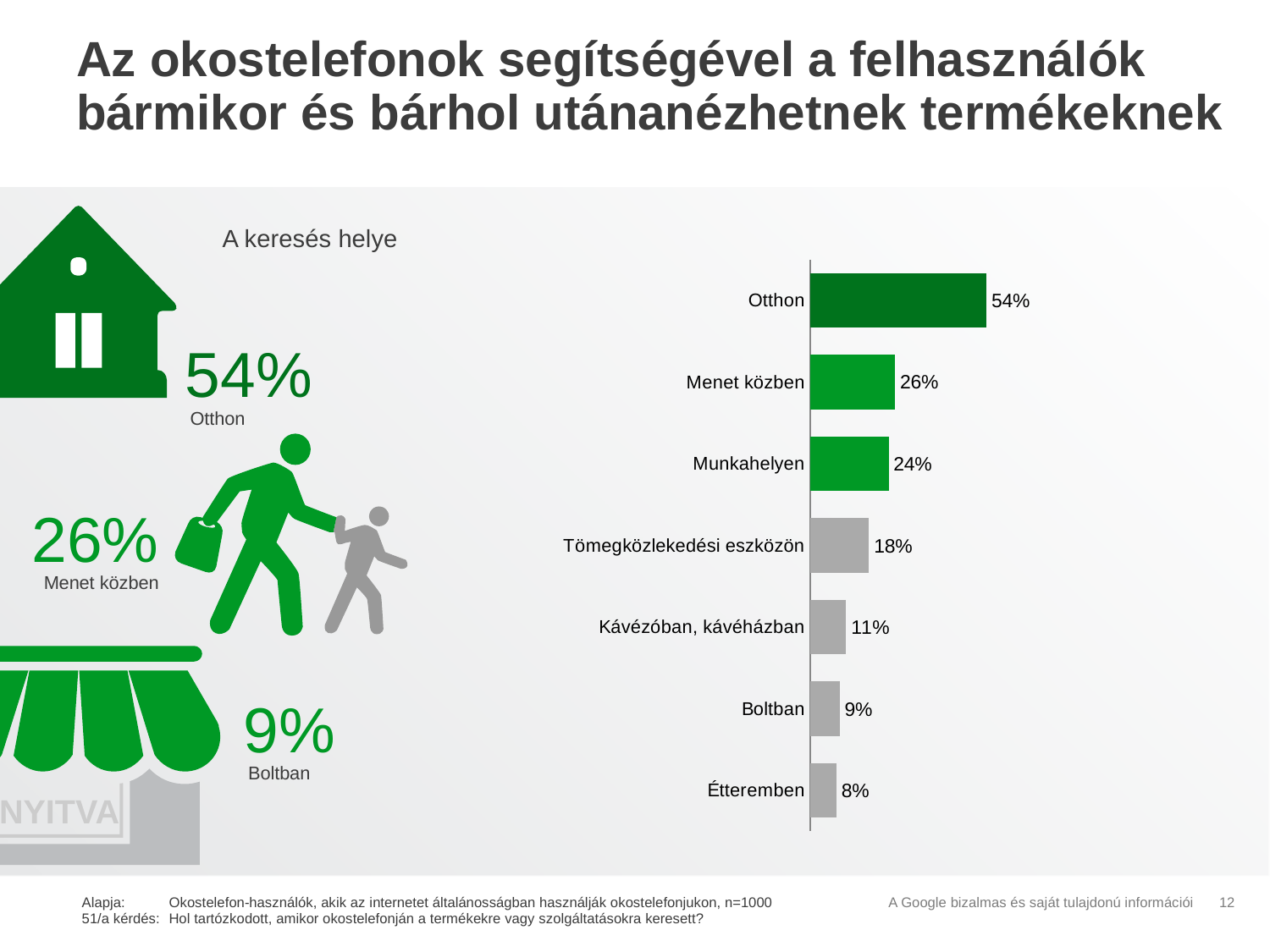
Which category has the highest value? Otthon Which is larger, the value for Menet közben or the value for Munkahelyen? Menet közben What is the value for Kávézóban, kávéházban? 11% What is the title of the chart? A keresés helye Which category has the lowest value? Étteremben What is the value for Étteremben? 8% How many categories are shown in the chart? 7 What is the difference between the values for Munkahelyen and Boltban? 15% What is the difference between the values for Otthon and Menet közben? 28% What kind of chart is shown on the slide? bar chart What is the value for Otthon? 54% What is the value for Tömegközlekedési eszközön? 18%